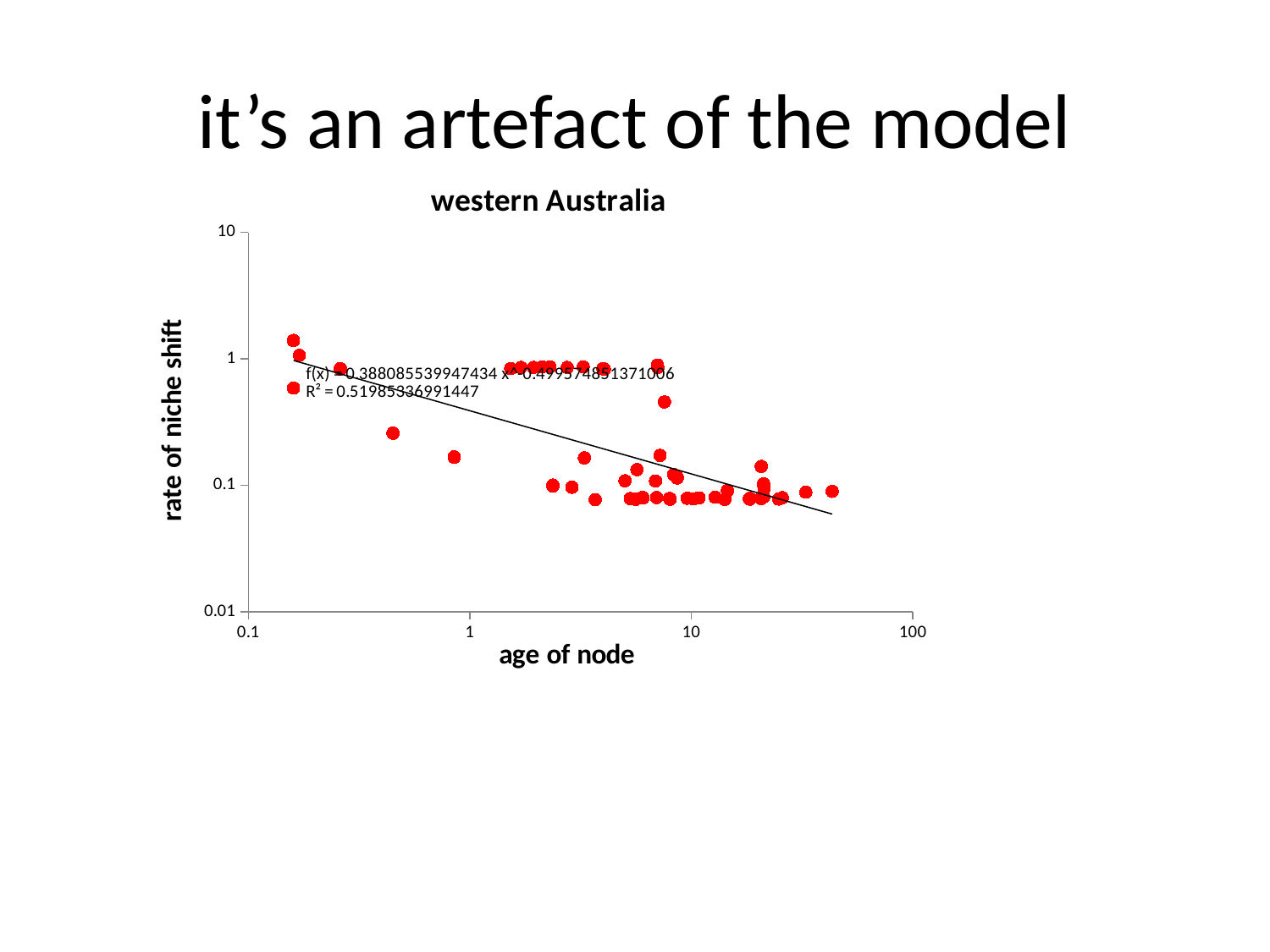
What is the title of the chart? western Australia What kind of chart is shown on the slide? scatter chart Which is larger: the rate of niche shift for the point near age of node 0.16 or the point near age of node 0.9? the point near age of node 0.16 What R² value is printed on the chart? R² = 0.51985336991447 What is the lowest value shown on the x axis? 0.1 How many tick labels are shown on the x axis? 4 Is the rate of niche shift for the point near age of node 0.45 greater or less than 0.1? greater What is the highest value shown on the y axis? 10 Do the values of rate of niche shift generally rise or fall as age of node increases? fall What is the label of the x axis? age of node Is the rate of niche shift for the highest point near age of node 0.16 greater or less than 1? greater Is the rate of niche shift for the point near age of node 0.45 greater or less than 1? less